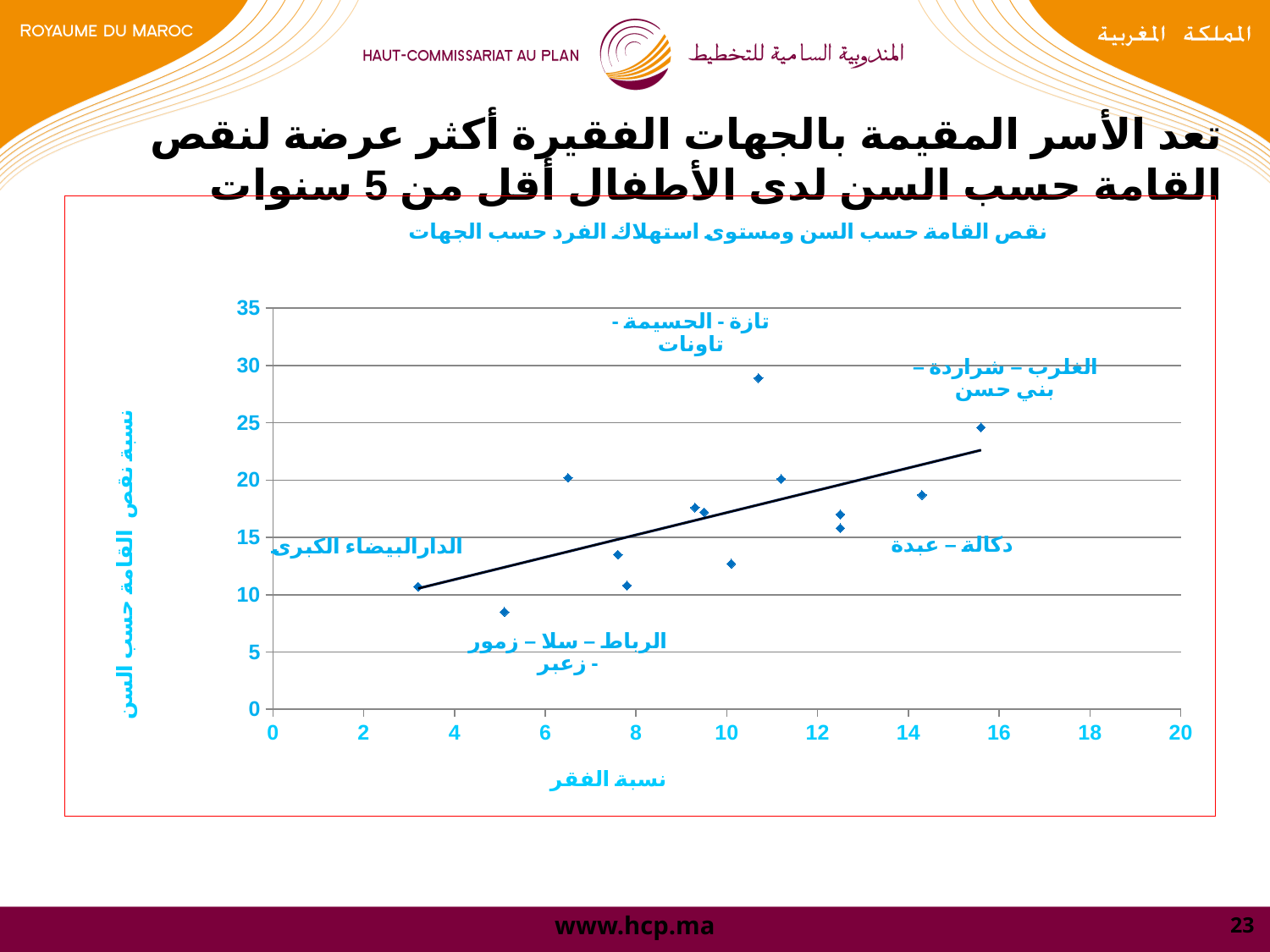
Which has the higher stunting rate, الغرب – شراردة – بني حسن or دكالة – عبدة? الغرب – شراردة – بني حسن What kind of chart is shown on the slide? scatter chart Is the stunting rate for دكالة – عبدة greater or less than 20? less Is the poverty rate (x value) for الغرب – شراردة – بني حسن greater or less than 14? greater Is the stunting rate for الدار البيضاء الكبرى greater or less than 15? less Which labelled region has the highest stunting rate (y value) in the chart? تازة - الحسيمة - تاونات What is the title of the x axis of the chart? نسبة الفقر Does the trend line in the chart rise or fall as the poverty rate increases along the x axis? rises What is the title of the y axis of the chart? نسبة نقص القامة حسب السن Which labelled region has the lowest stunting rate (y value) in the chart? الرباط – سلا – زمور - زعير